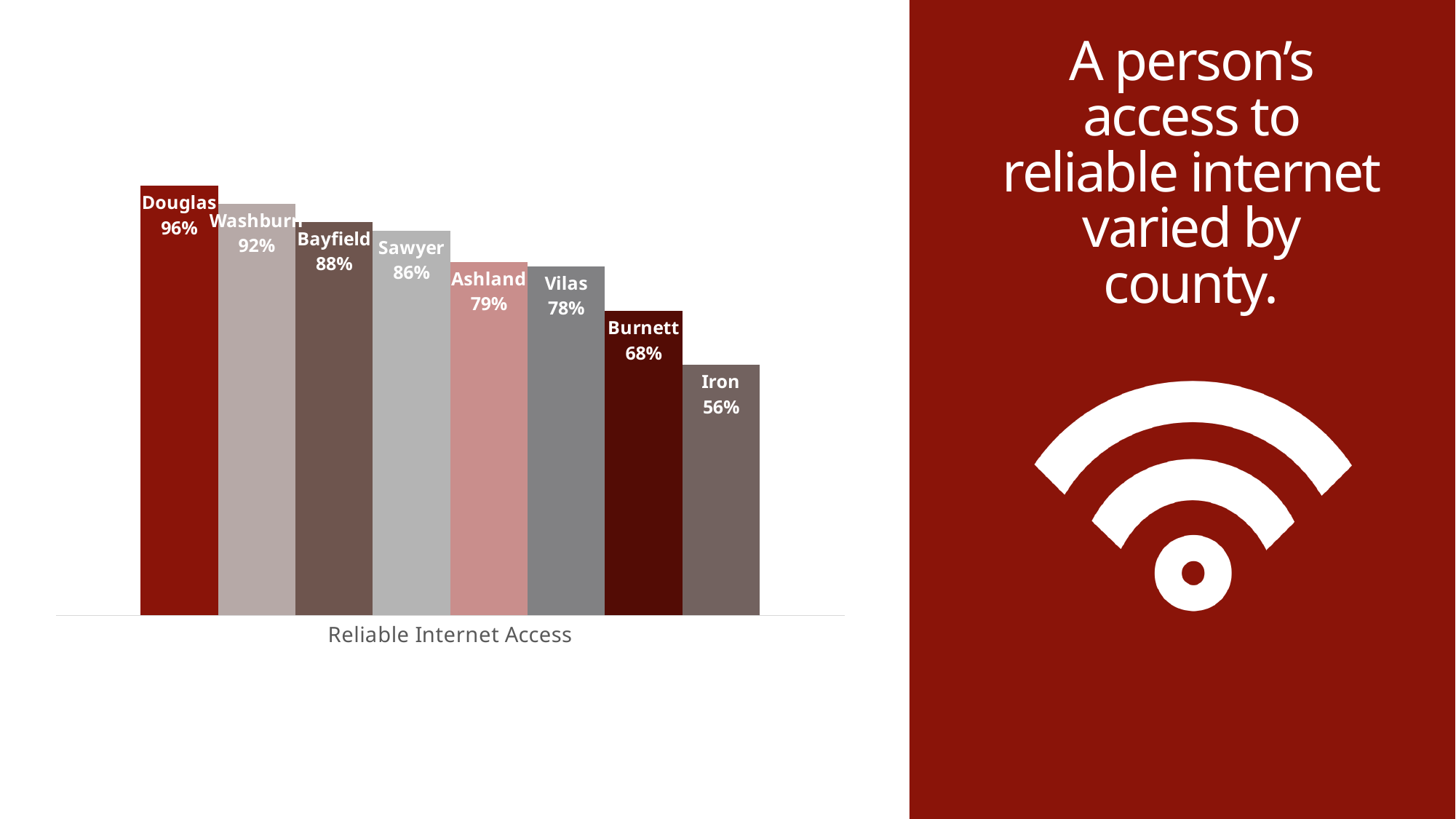
What is the reliable internet access value for Douglas county? 96% What is the difference in reliable internet access between Washburn and Bayfield? 4% Which has higher reliable internet access, Ashland or Burnett? Ashland What is the difference in reliable internet access between Douglas and Iron? 40% What is the reliable internet access value for Burnett county? 68% Which county has the highest reliable internet access? Douglas Do the values rise or fall from left to right across the chart? Fall What kind of chart is shown on the slide? Bar chart What is the reliable internet access value for Sawyer county? 86% What is the label shown beneath the chart's horizontal axis? Reliable Internet Access Which county has the lowest reliable internet access? Iron How many counties are shown in the chart? 8